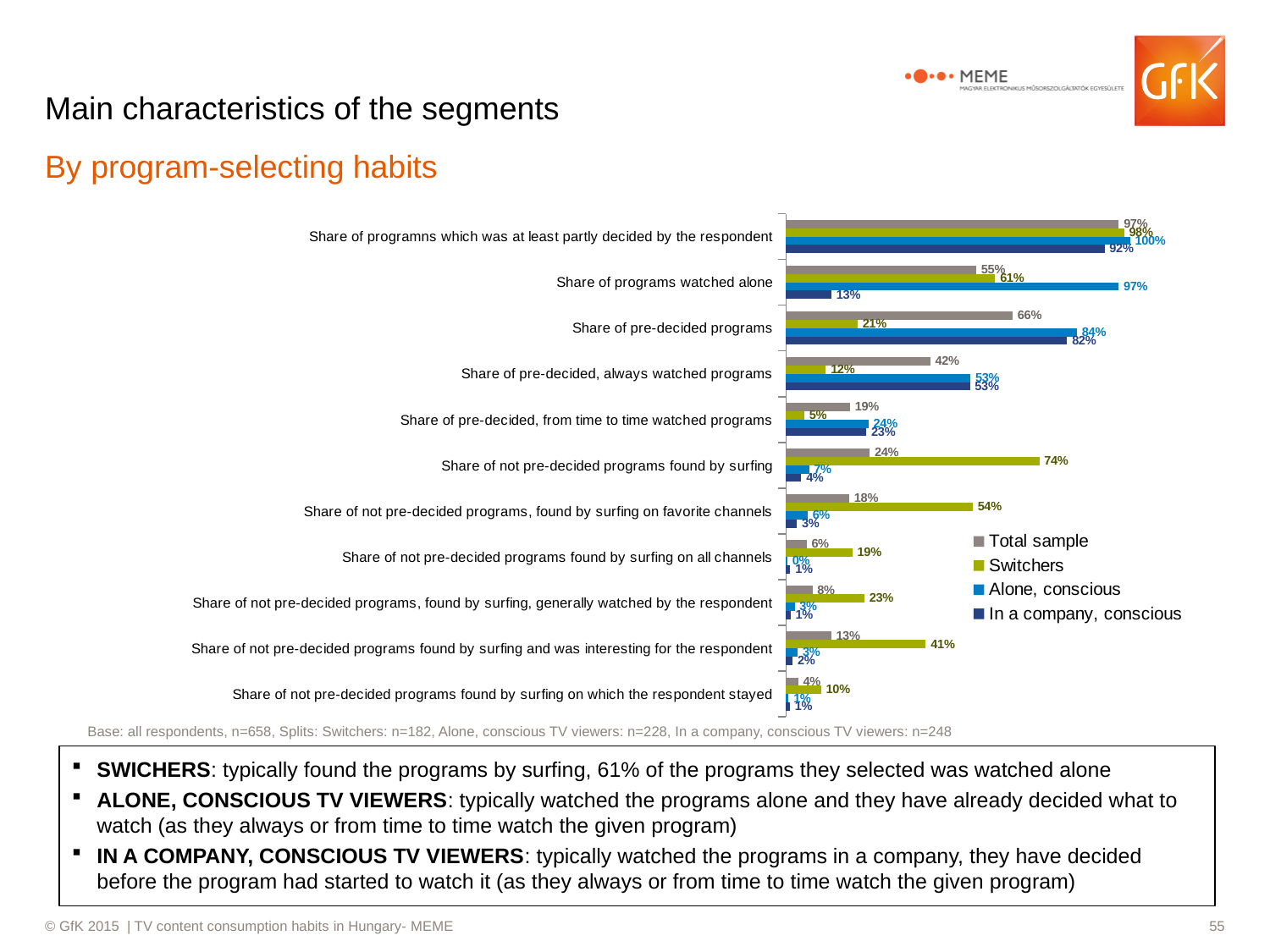
What is the Switchers value for 'Share of not pre-decided programs found by surfing'? 74% Which series is shown in gray in the legend? Total sample What is the Total sample value for 'Share of pre-decided programs'? 66% For 'Share of pre-decided, always watched programs', which is larger: the Total sample value or the Switchers value? Total sample What is the 'Alone, conscious' value for 'Share of programs watched alone'? 97% What is the 'In a company, conscious' value for 'Share of programs watched alone'? 13% Which series has the highest value for 'Share of pre-decided programs'? Alone, conscious How many categories are shown on the chart? 11 How many series does the legend list? 4 What type of chart is shown on the slide? Bar chart Which series has the lowest value for 'Share of not pre-decided programs found by surfing'? In a company, conscious What is the difference between the Switchers and Total sample values for 'Share of not pre-decided programs found by surfing and was interesting for the respondent'? 28%